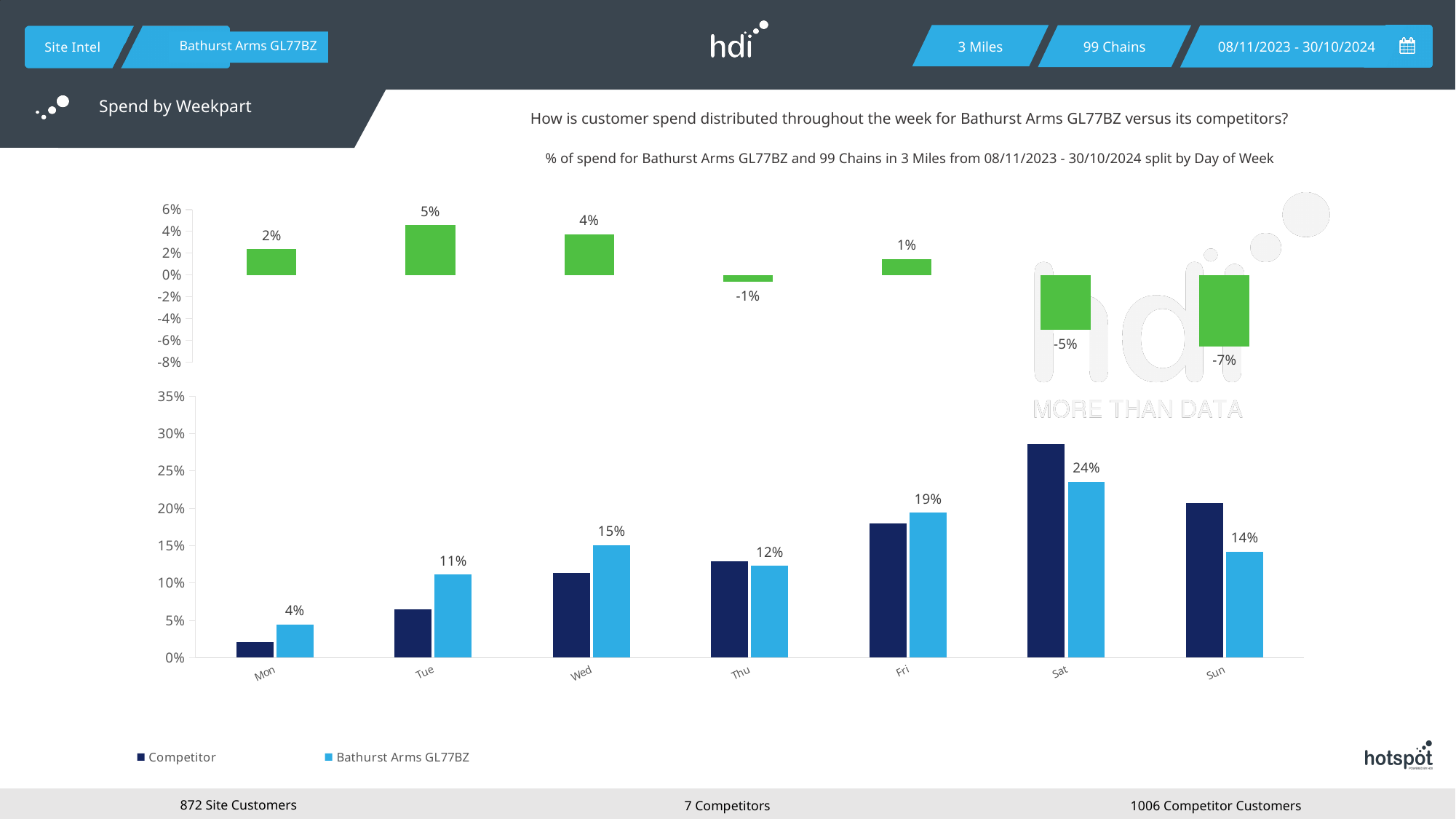
In the bottom chart, is the Competitor value for Mon greater or less than 5%? less In the bottom chart, is the Competitor value for Sat greater or less than 25%? greater In the bottom chart, what is the difference between the Bathurst Arms GL77BZ values for Fri and Thu? 7% In the top chart, what is the value for Sun? -7% In the top chart, which day has the highest value? Tue How many series does the legend of the bottom chart list? 2 In the bottom chart, what is the value for Bathurst Arms GL77BZ on Sat? 24% How many days are shown on the x axis of the bottom chart? 7 In the bottom chart, which is larger on Sun: the Competitor value or the Bathurst Arms GL77BZ value? Competitor In the bottom chart, which day has the lowest value for Bathurst Arms GL77BZ? Mon In the bottom chart, which day has the highest value for Bathurst Arms GL77BZ? Sat In the bottom chart, what is the value for Bathurst Arms GL77BZ on Mon? 4%